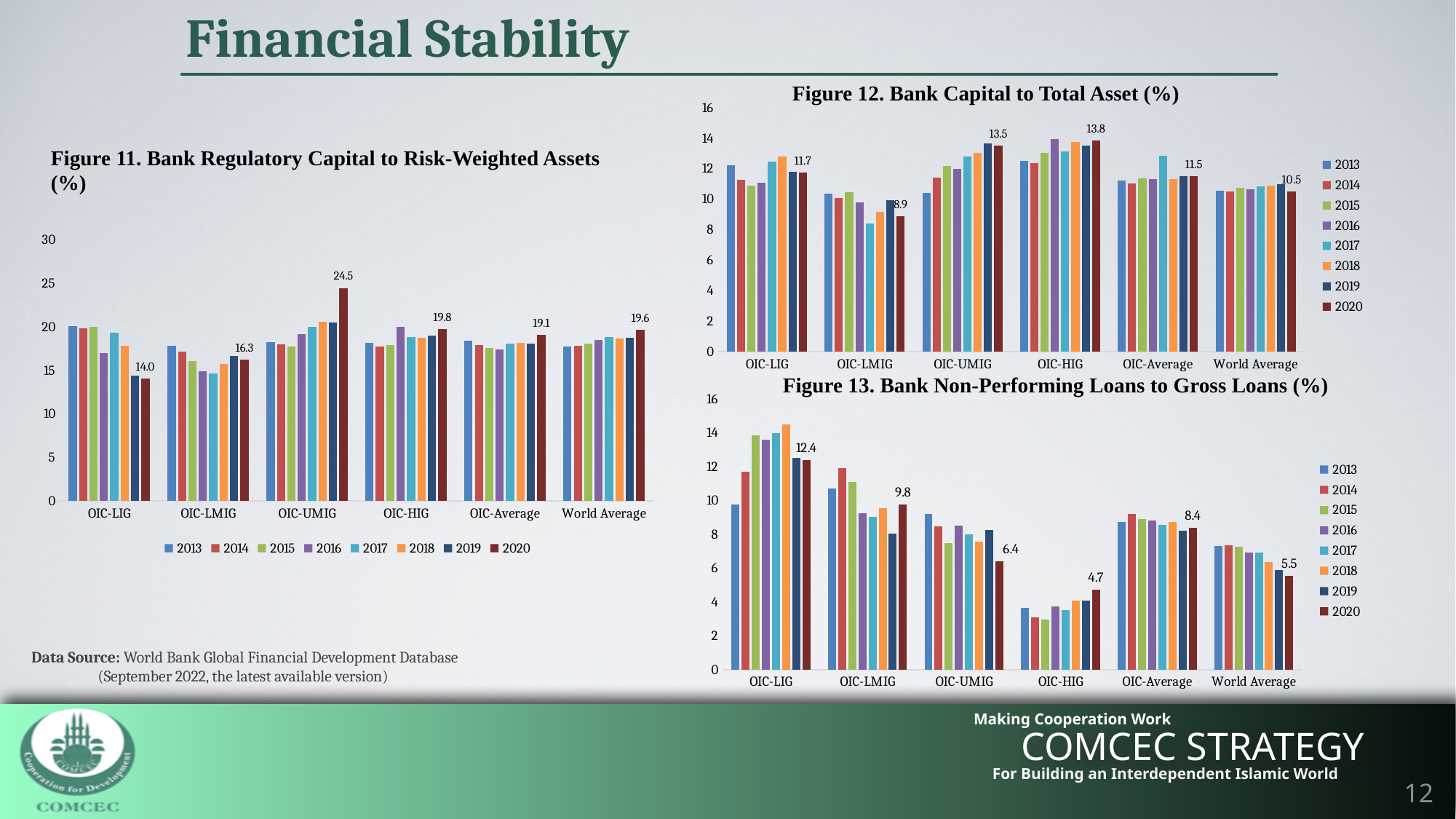
In Figure 11, what is the difference between the 2020 values for World Average and OIC-Average? 0.5 What kind of chart is Figure 12? bar chart How many series does the legend of Figure 13 list? 8 In Figure 13, is the 2013 value for OIC-LIG greater or less than 8? greater In Figure 11, what is the 2020 value for OIC-UMIG? 24.5 In Figure 11, which category has the highest 2020 value? OIC-UMIG In Figure 12, what is the 2020 value for OIC-HIG? 13.8 In Figure 13, what is the difference between the 2020 values for OIC-LMIG and OIC-HIG? 5.1 In Figure 11, what is the 2020 value for OIC-LIG? 14.0 In Figure 12, is the 2020 value for OIC-LIG larger or smaller than the 2020 value for OIC-Average? larger In Figure 13, what is the 2020 value for OIC-LIG? 12.4 In Figure 12, which category has the lowest 2020 value? OIC-LMIG